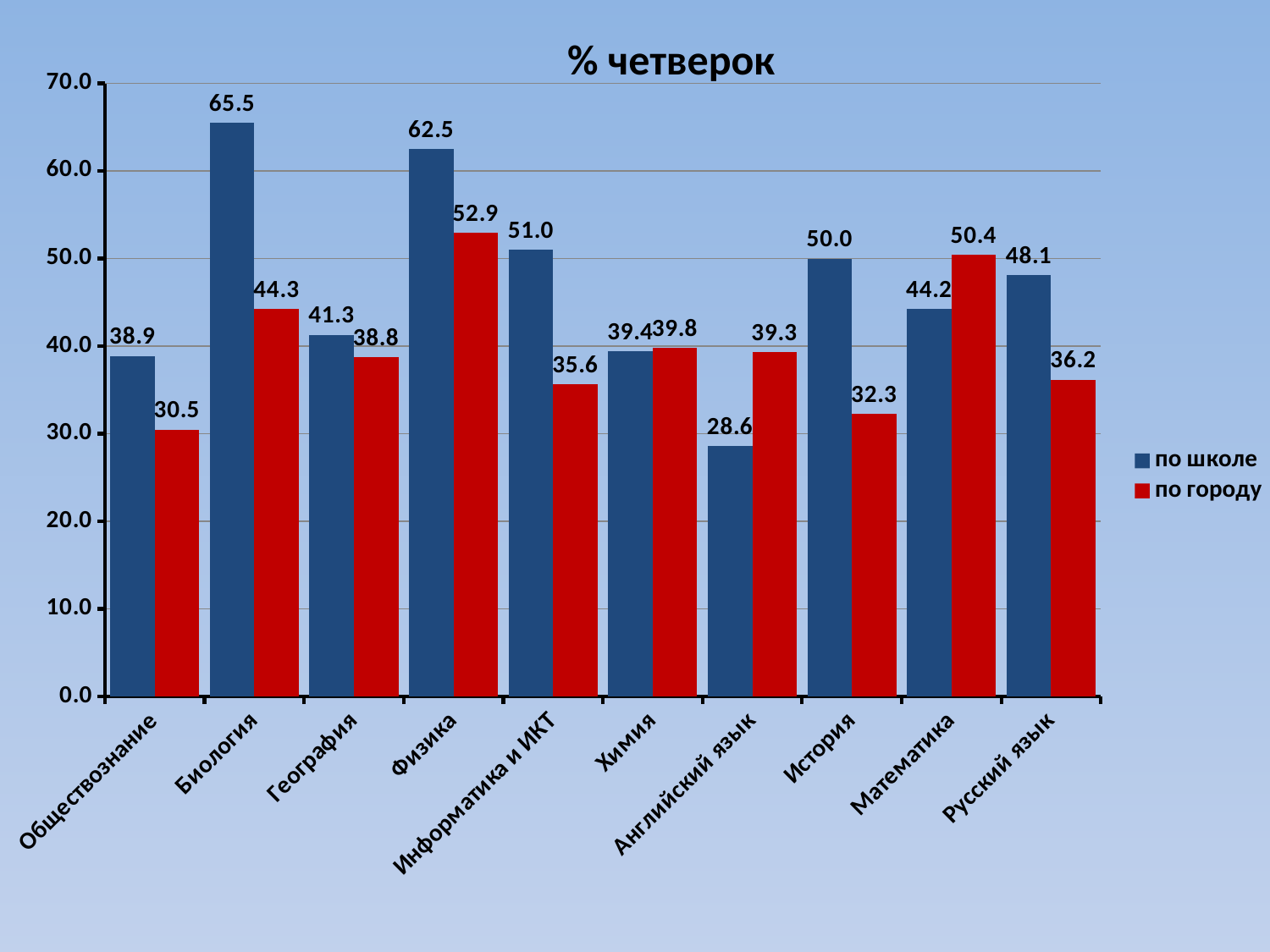
Which category has the lowest value in the по городу series? Обществознание What kind of chart is shown on the slide? bar chart Is the по школе value for История greater or less than 40.0? greater What is the value for Биология in the по школе series? 65.5 What is the difference between the по школе and по городу values for Физика? 9.6 What is the title of the chart? % четверок Which category has the highest value in the по школе series? Биология How many categories are shown on the x axis? 10 Which is larger for Математика: the по школе value or the по городу value? по городу What is the value for Английский язык in the по школе series? 28.6 What is the value for Математика in the по городу series? 50.4 How many series does the legend list? 2